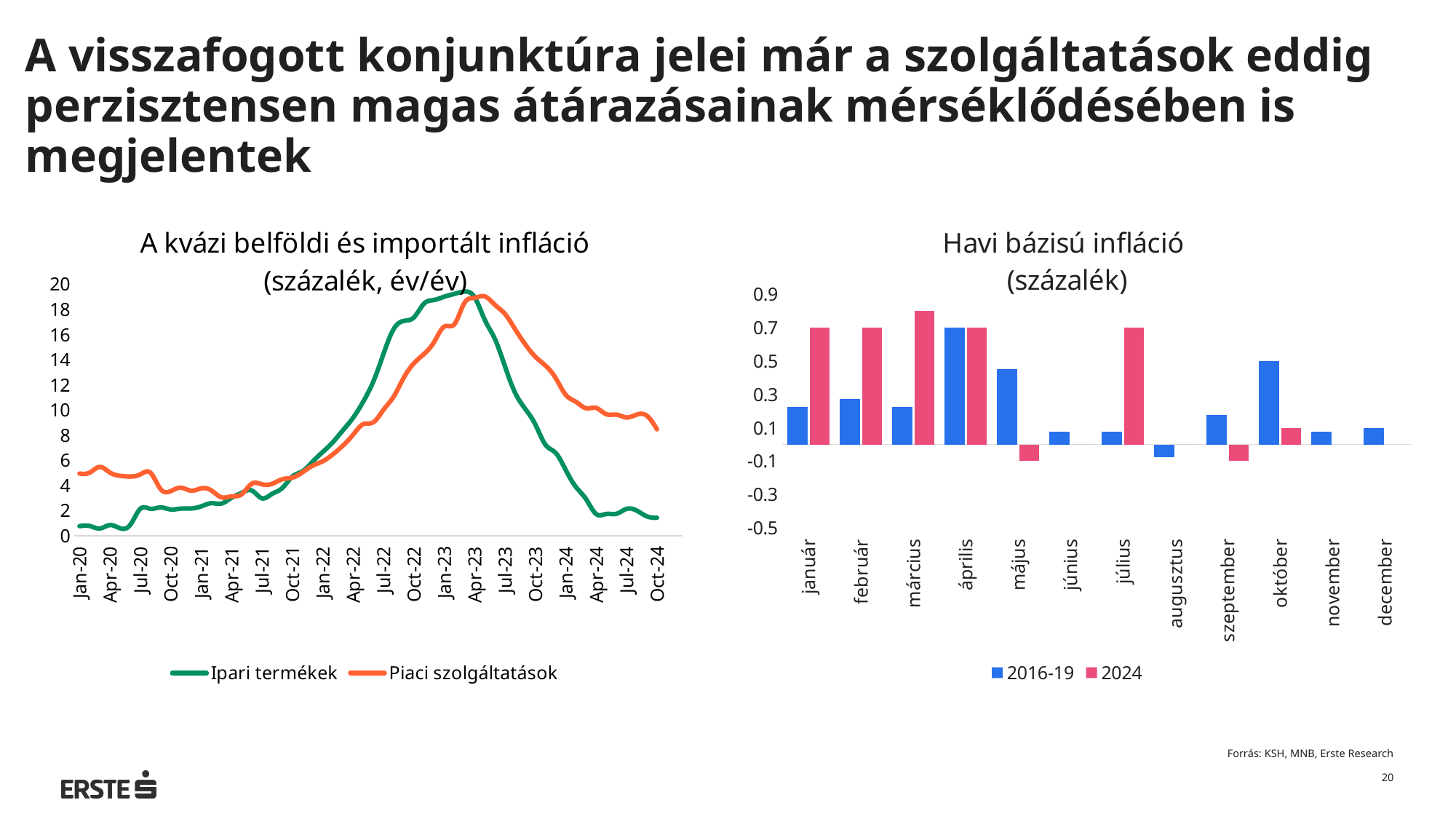
How many series does the legend of the right chart list? 2 How many months are shown on the x axis of the right chart, 'Havi bázisú infláció'? 12 In the left chart, do the values of 'Ipari termékek' rise or fall between Apr-23 and Apr-24? fall In the right chart, 'Havi bázisú infláció', which is larger for január: the 2016-19 value or the 2024 value? 2024 What kind of chart is the left chart, 'A kvázi belföldi és importált infláció'? line chart What kind of chart is the right chart, 'Havi bázisú infláció'? bar chart In the right chart, 'Havi bázisú infláció', which month has the highest 2024 value? március In the left chart, which series is higher at Oct-24: 'Ipari termékek' or 'Piaci szolgáltatások'? Piaci szolgáltatások How many series does the legend of the left chart list? 2 In the right chart, 'Havi bázisú infláció', is the 2024 value for május greater or less than 0? less In the right chart, 'Havi bázisú infláció', is the 2016-19 value for október greater or less than 0.3? greater In the left chart, is the value of 'Ipari termékek' at Oct-24 greater or less than 4? less